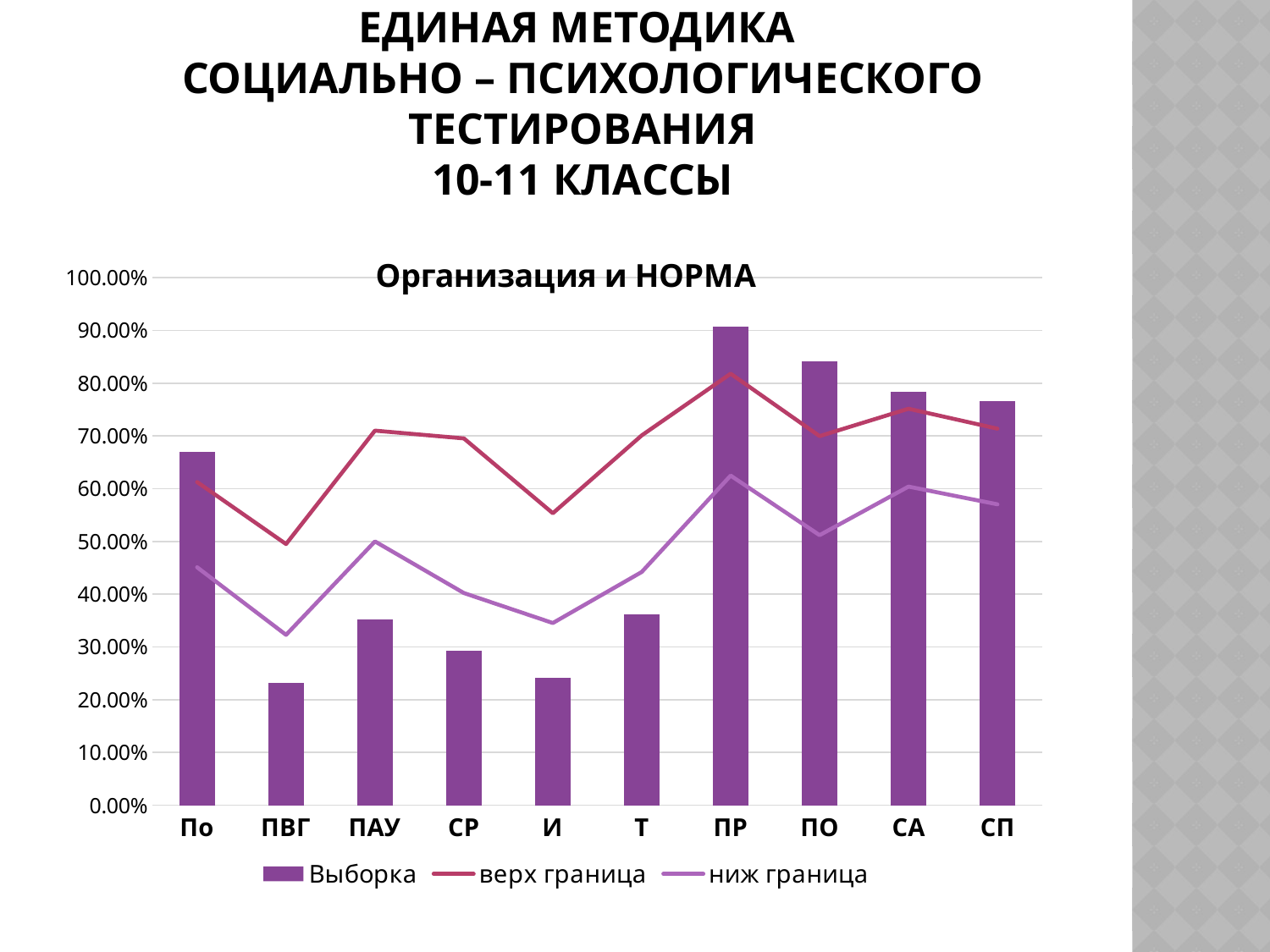
Is the Выборка value for ПР greater or less than 80.00%? greater Which category has the highest Выборка bar? ПР How many series does the legend list? 3 Which series is drawn as bars in the chart? Выборка How many categories are shown on the x axis? 10 Is the Выборка value for Т greater or less than 40.00%? less Is the ниж граница value for ПВГ greater or less than 40.00%? less What is the title of the chart? Организация и НОРМА What kind of chart is this? bar chart with two line series Which has the larger Выборка value, ПО or СА? ПО